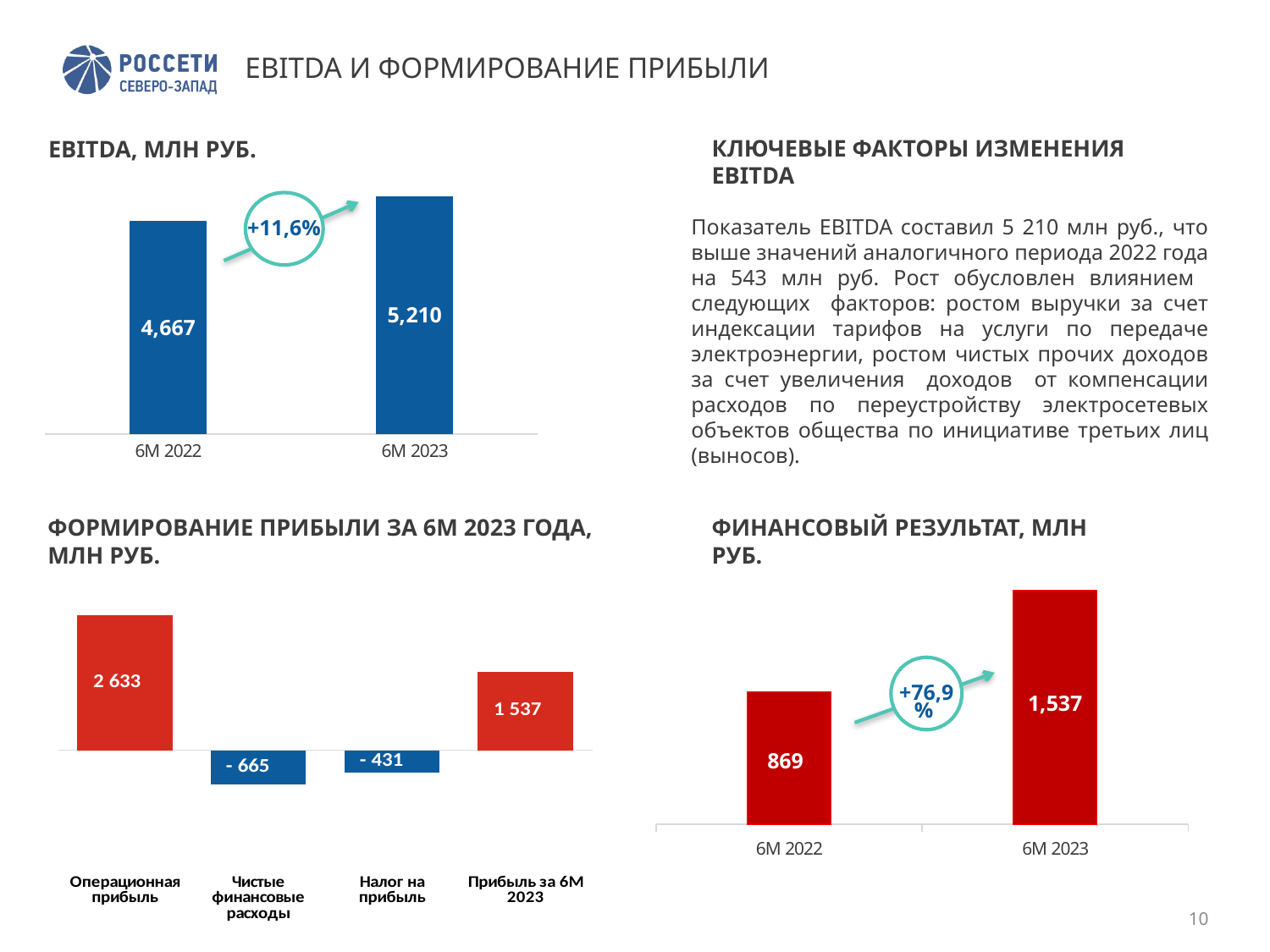
In the 'ФОРМИРОВАНИЕ ПРИБЫЛИ ЗА 6М 2023 ГОДА, МЛН РУБ.' chart, what is the value for Операционная прибыль? 2 633 What type of chart is the 'ФИНАНСОВЫЙ РЕЗУЛЬТАТ, МЛН РУБ.' chart? Bar chart In the 'ФОРМИРОВАНИЕ ПРИБЫЛИ ЗА 6М 2023 ГОДА, МЛН РУБ.' chart, what is the value for Налог на прибыль? - 431 In the 'ФИНАНСОВЫЙ РЕЗУЛЬТАТ, МЛН РУБ.' chart, what is the difference between the 6M 2023 and 6M 2022 values? 668 In the 'EBITDA, МЛН РУБ.' chart, what is the value for 6M 2022? 4,667 In the 'ФОРМИРОВАНИЕ ПРИБЫЛИ ЗА 6М 2023 ГОДА, МЛН РУБ.' chart, how many categories are shown? 4 In the 'EBITDA, МЛН РУБ.' chart, what percentage change is shown between 6M 2022 and 6M 2023? +11,6% In the 'EBITDA, МЛН РУБ.' chart, what is the difference between the 6M 2023 and 6M 2022 values? 543 In the 'ФИНАНСОВЫЙ РЕЗУЛЬТАТ, МЛН РУБ.' chart, what is the value for 6M 2022? 869 In the 'ФОРМИРОВАНИЕ ПРИБЫЛИ ЗА 6М 2023 ГОДА, МЛН РУБ.' chart, what is the value for Чистые финансовые расходы? - 665 In the 'EBITDA, МЛН РУБ.' chart, what is the value for 6M 2023? 5,210 In the 'ФОРМИРОВАНИЕ ПРИБЫЛИ ЗА 6М 2023 ГОДА, МЛН РУБ.' chart, which category has the highest value? Операционная прибыль